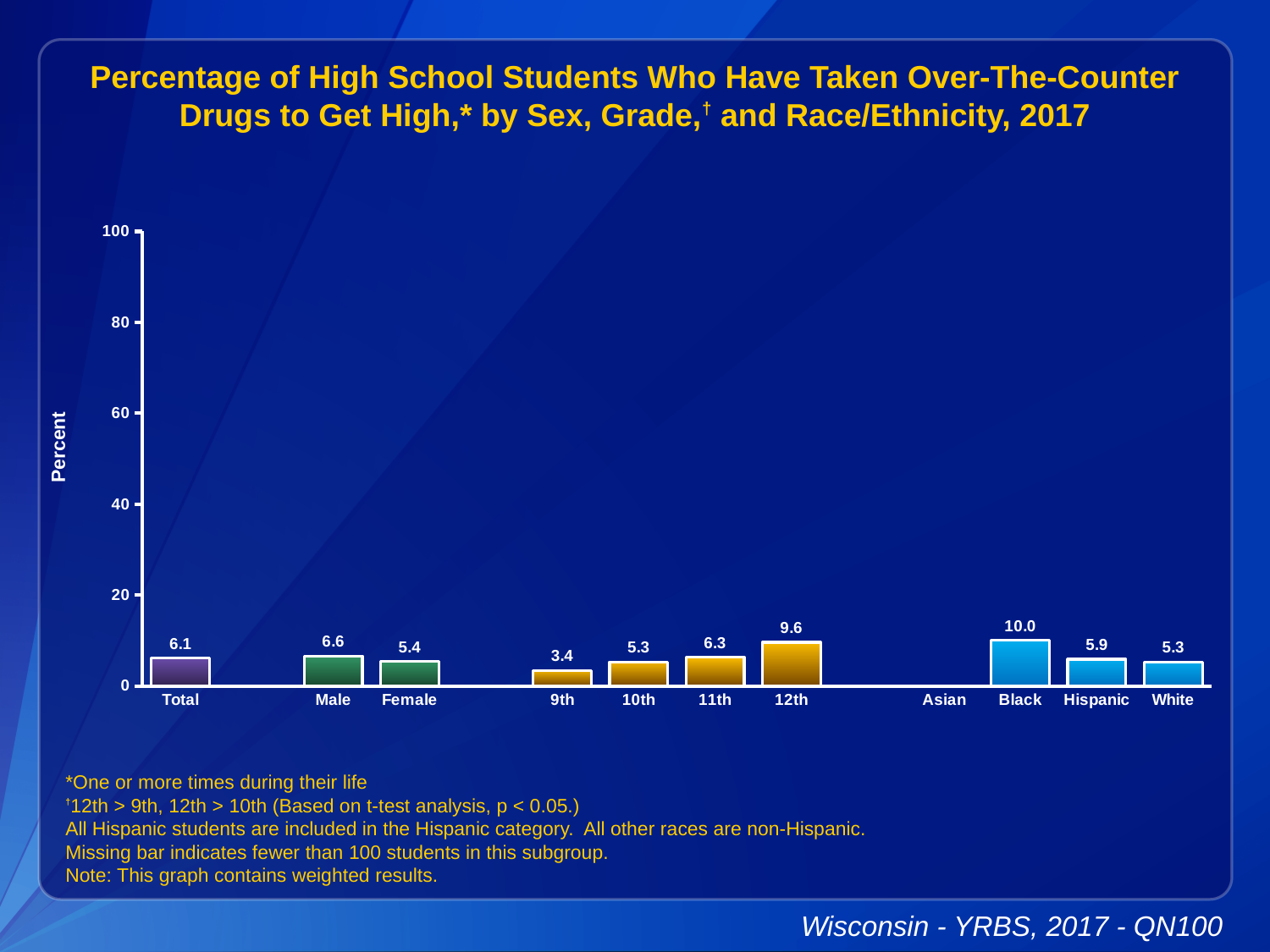
How many categories are labeled on the x axis? 11 What is the value for Total? 6.1 Which is larger, the value for 12th grade or the value for 9th grade? 12th Which category with a bar has the lowest value? 9th What is the value for 12th grade? 9.6 What is the difference between the values for Male and Female? 1.2 Do the values rise or fall from 9th grade to 12th grade? rise Is the value for Black students greater or less than 20? less Which category has no bar shown? Asian Which category has the highest value? Black What kind of chart is shown? bar chart What is the value for Black students? 10.0